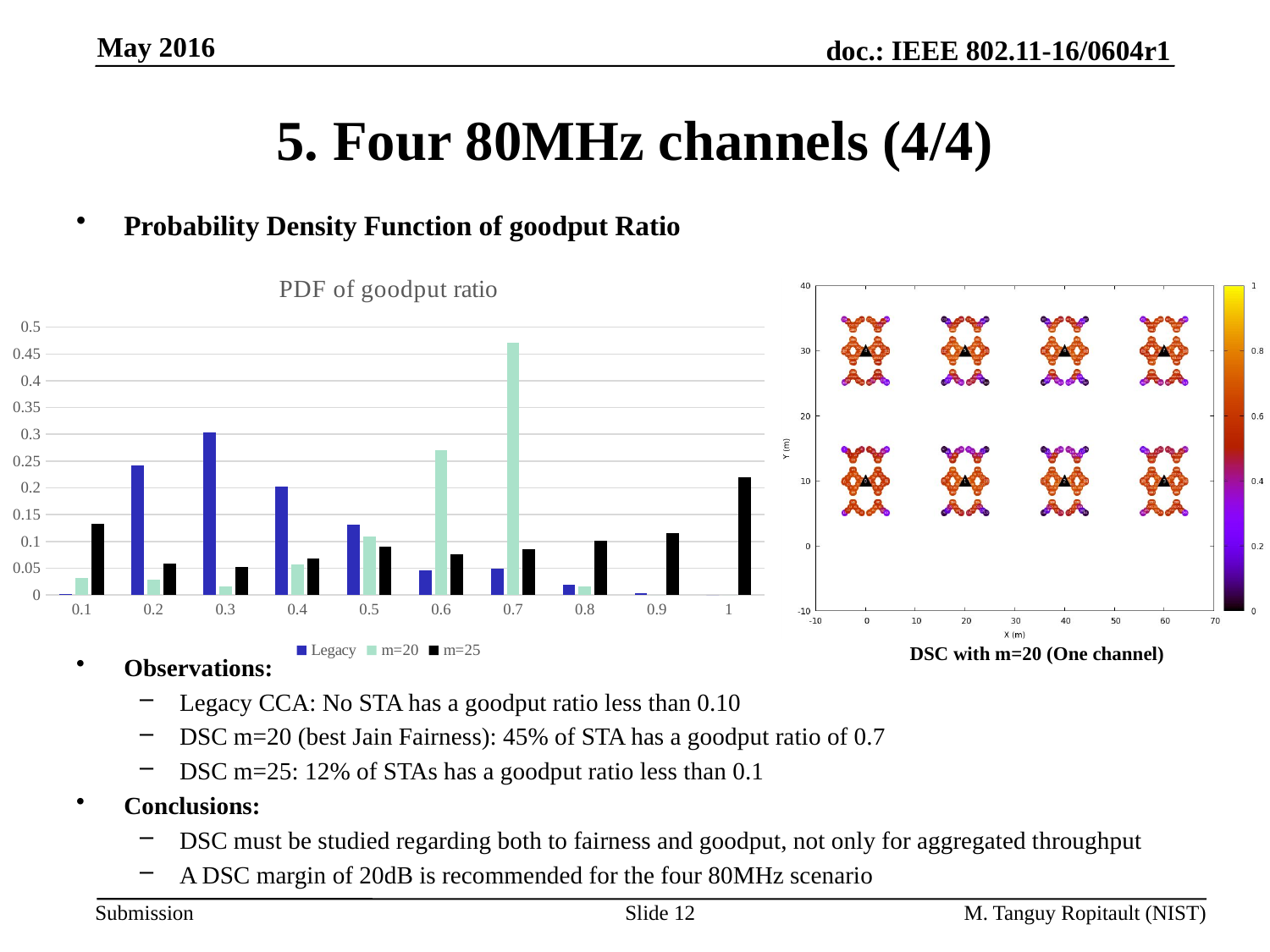
What is the title of the bar chart on the slide? PDF of goodput ratio In the 'PDF of goodput ratio' chart, at which goodput ratio does the Legacy series reach its highest value? 0.3 What kind of chart is the 'PDF of goodput ratio' chart? bar chart In the 'PDF of goodput ratio' chart, is the m=25 value at goodput ratio 1 greater or less than 0.15? greater In the 'PDF of goodput ratio' chart, is the Legacy value at goodput ratio 0.3 greater or less than 0.25? greater In the 'PDF of goodput ratio' chart, at which goodput ratio does the m=25 series reach its highest value? 1 In the 'PDF of goodput ratio' chart, is the m=20 value at goodput ratio 0.7 greater or less than 0.4? greater How many goodput ratio categories are shown on the x axis of the 'PDF of goodput ratio' chart? 10 In the 'PDF of goodput ratio' chart, at goodput ratio 0.7, which series has the larger value: Legacy or m=20? m=20 In the 'PDF of goodput ratio' chart, at which goodput ratio does the m=20 series reach its highest value? 0.7 How many series does the legend of the 'PDF of goodput ratio' chart list? 3 In the 'PDF of goodput ratio' chart, at goodput ratio 0.2, which series has the larger value: Legacy or m=25? Legacy